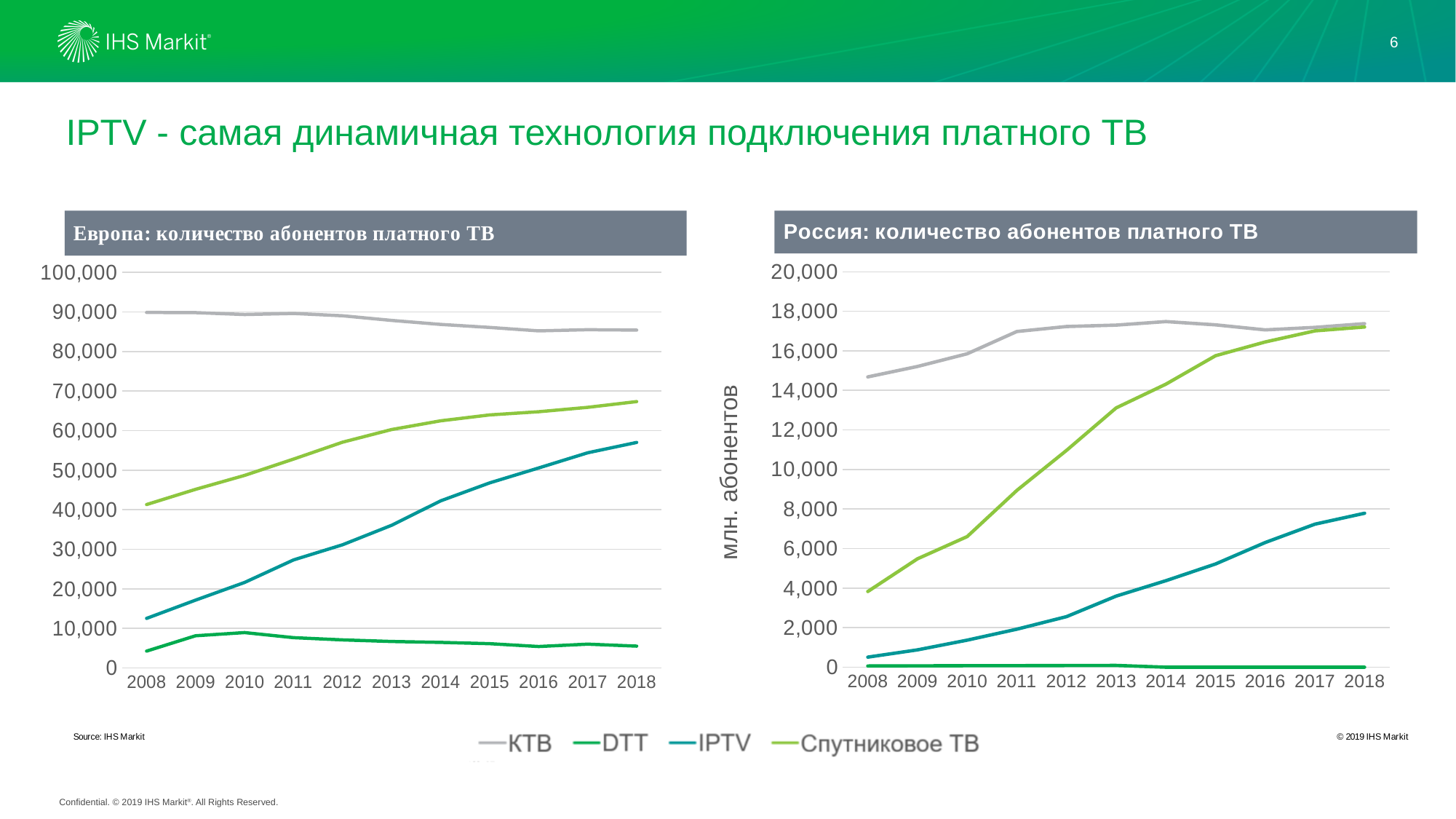
In the chart titled "Россия: количество абонентов платного ТВ", is the value for Спутниковое ТВ in 2008 greater or less than 6,000? less In the chart titled "Россия: количество абонентов платного ТВ", how many years are shown on the x axis? 11 In the chart titled "Россия: количество абонентов платного ТВ", does the IPTV series rise or fall from 2008 to 2018? rise In the chart titled "Россия: количество абонентов платного ТВ", which series has the lowest values across all years? DTT What is the y-axis label of the chart titled "Россия: количество абонентов платного ТВ"? млн. абонентов In the chart titled "Европа: количество абонентов платного ТВ", which series has the highest values across all years? КТВ How many series does the shared legend list for the charts on the slide? 4 In the chart titled "Европа: количество абонентов платного ТВ", which series has the lowest value in 2018? DTT In the chart titled "Россия: количество абонентов платного ТВ", which is larger in 2012: the value for Спутниковое ТВ or the value for IPTV? Спутниковое ТВ What kind of chart is the chart titled "Европа: количество абонентов платного ТВ"? line chart In the chart titled "Европа: количество абонентов платного ТВ", is the value for IPTV in 2018 greater or less than 50,000? greater In the chart titled "Европа: количество абонентов платного ТВ", does the IPTV series rise or fall from 2008 to 2018? rise